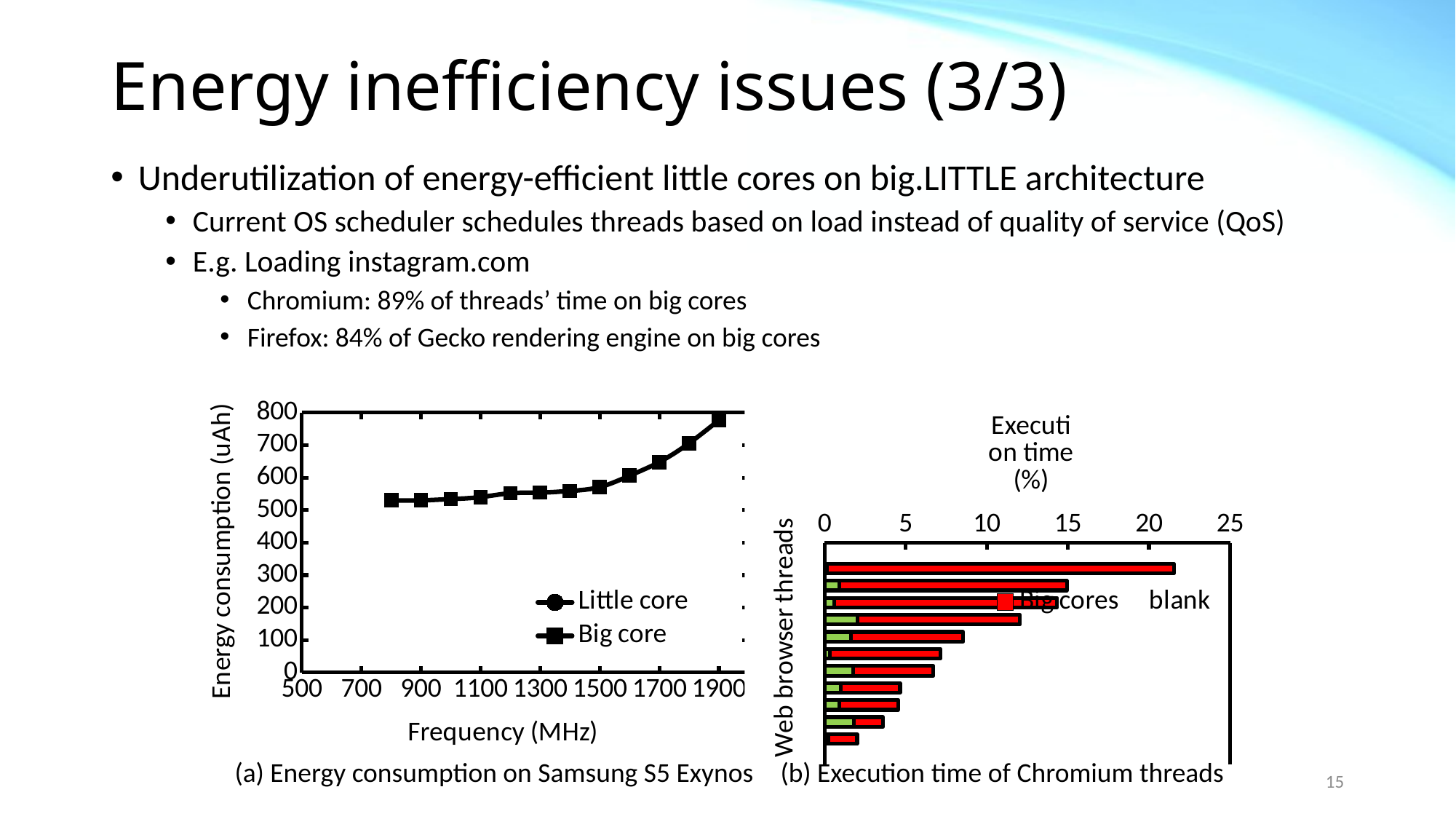
What is the x-axis label of chart (a)? Frequency (MHz) In chart (b), is the value of the shortest (bottom) bar greater or less than 5? less In chart (a), is the Big core energy consumption at 1900 MHz greater or less than 700? greater What kind of chart is chart (a), Energy consumption on Samsung S5 Exynos? line chart In chart (a), does the Big core energy consumption rise or fall as frequency increases? rise In chart (a), how many series does the legend list? 2 In chart (a), how many data points are plotted on the Big core line? 12 What kind of chart is chart (b), Execution time of Chromium threads? bar chart In chart (b), is the value of the longest (top) bar greater or less than 20? greater In chart (b), how many bars are plotted? 11